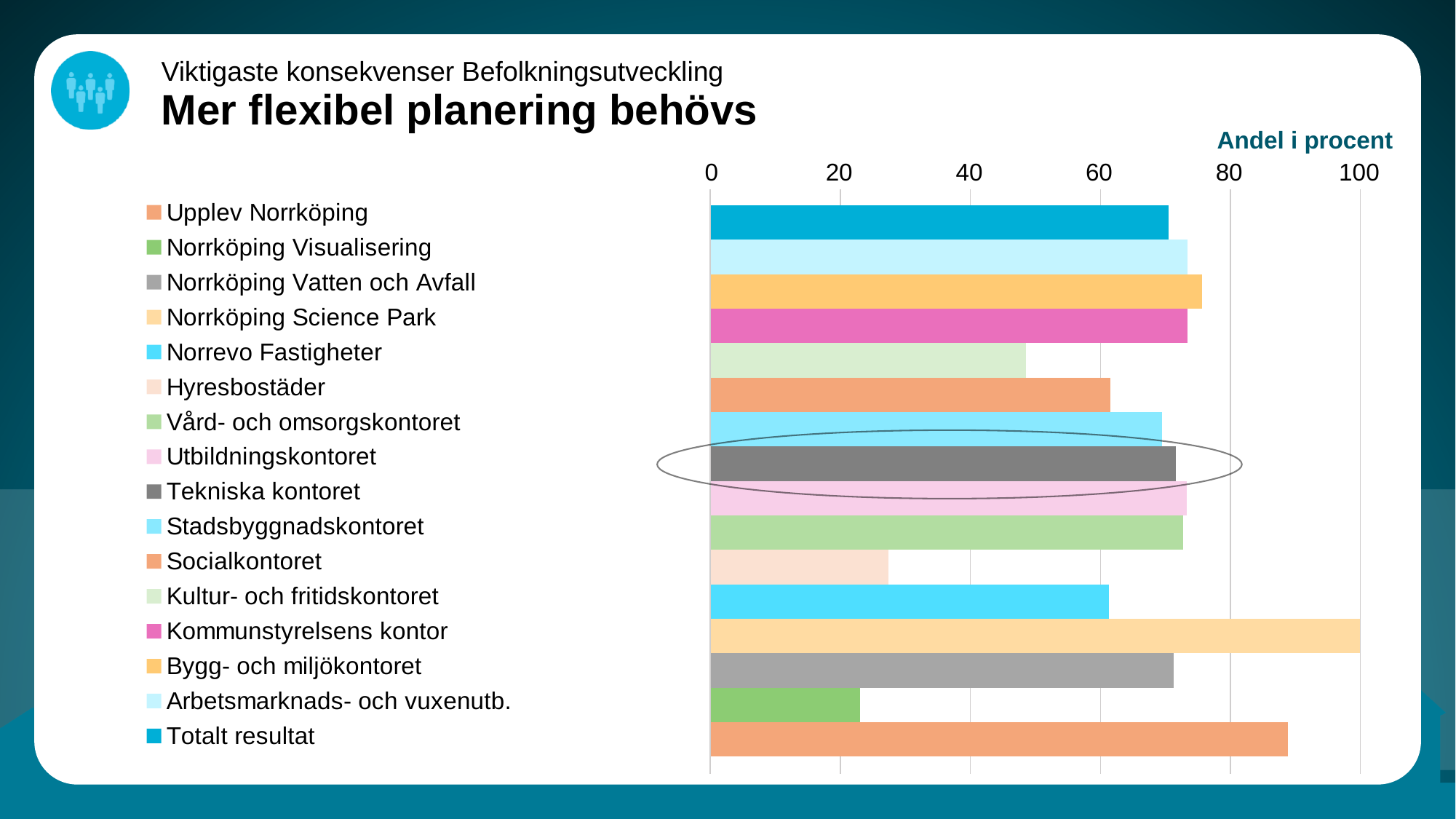
Is the value for Hyresbostäder greater or less than 40? less Which series has the highest value? Norrköping Science Park What kind of chart is shown on the slide? Bar chart Is the value for Kultur- och fritidskontoret greater or less than 60? less How many series does the legend list? 16 Is the value for Upplev Norrköping greater or less than 80? greater Which is larger, the value for Upplev Norrköping or the value for Socialkontoret? Upplev Norrköping What is the label shown above the horizontal axis of the chart? Andel i procent Which series has the lowest value? Norrköping Visualisering Which is larger, the value for Kultur- och fritidskontoret or the value for Hyresbostäder? Kultur- och fritidskontoret What is the value for Norrköping Science Park? 100